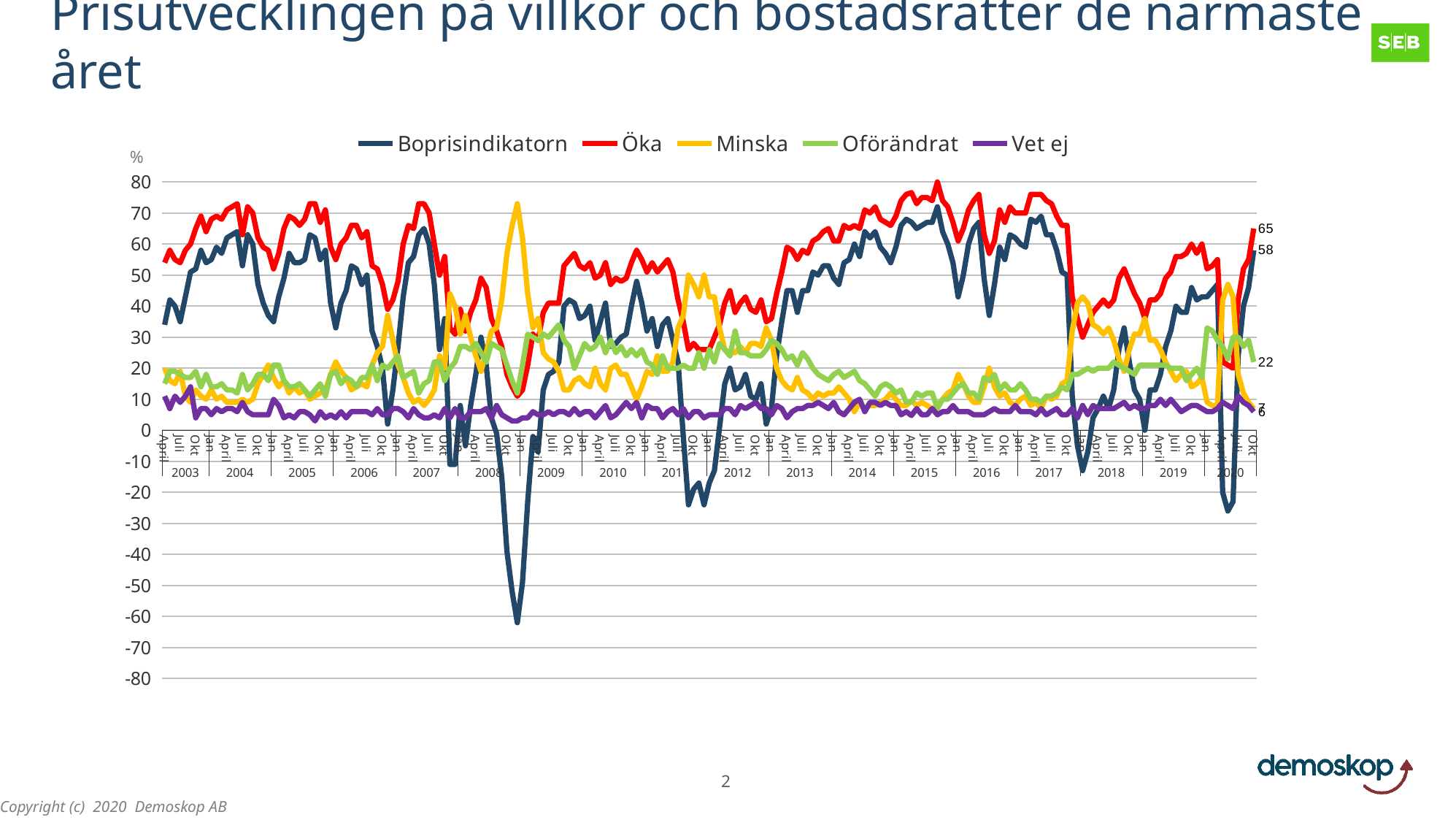
What is the latest labelled value for the Oförändrat series? 22 Is the lowest value of the Boprisindikatorn series (around early 2009) greater or less than -50? less At the latest labelled point, what is the difference between Öka (65) and Oförändrat (22)? 43 What colour is the Öka series line in the legend? red At the latest labelled point, what is the difference between Öka (65) and Boprisindikatorn (58)? 7 What is the latest labelled value for the Boprisindikatorn series? 58 At the latest labelled point, which is larger: Öka or Oförändrat? Öka What is the latest labelled value for the Öka series? 65 What kind of chart is shown on the slide? line chart Is the value for Vet ej in 2015 greater or less than 20? less Which series reaches the lowest value anywhere on the chart? Boprisindikatorn How many series does the legend list? 5